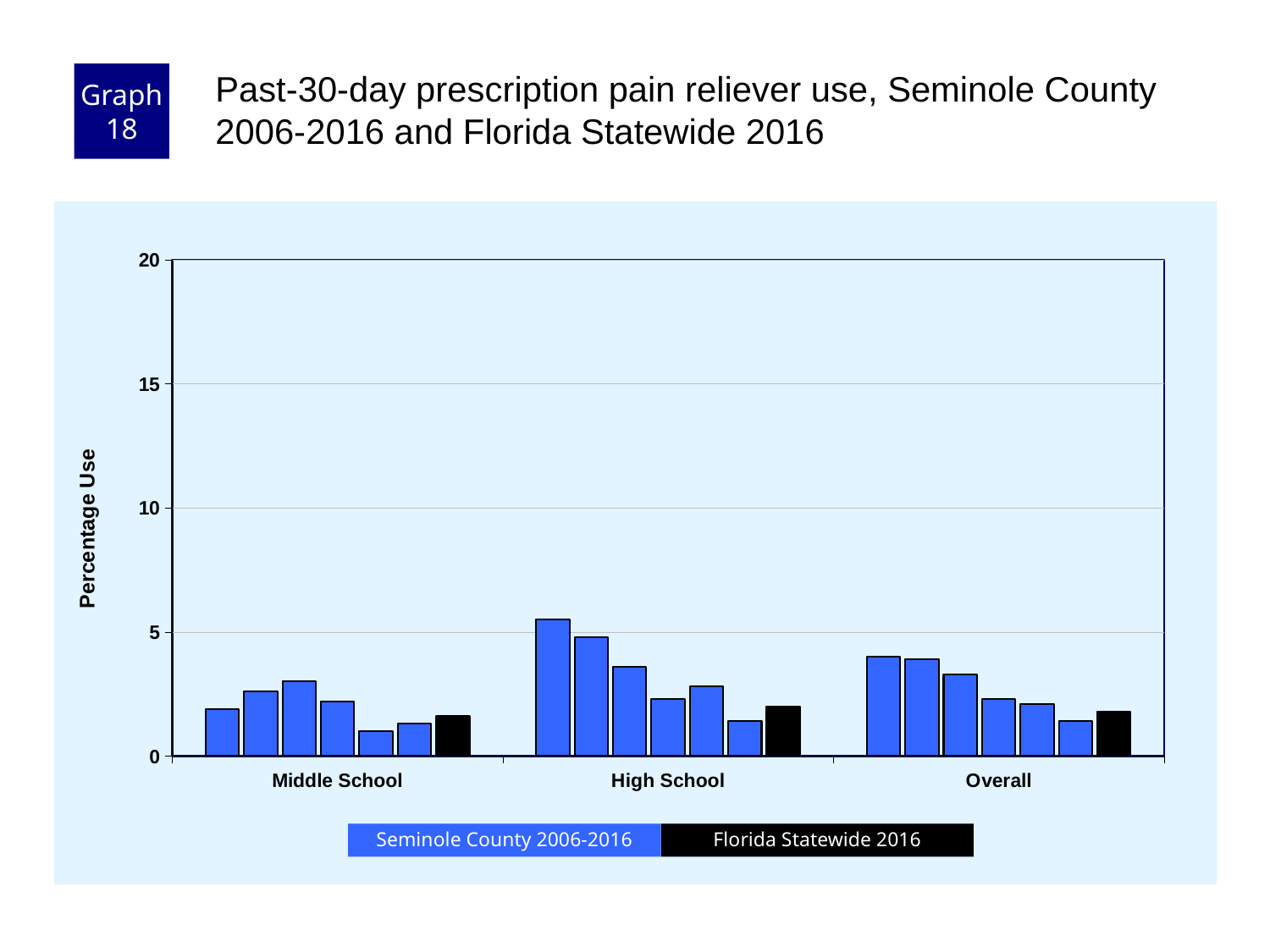
What kind of chart is shown on the slide? bar chart What is the label on the y axis? Percentage Use How many categories are shown on the x axis? 3 Is the value for the tallest Seminole County bar in the High School group greater or less than 5? greater Do the Seminole County 2006-2016 bars in the High School group generally rise or fall from left to right? fall Are any bars in the Overall group greater than 10? no What colour represents Florida Statewide 2016 in the legend? black Is the value for the Florida Statewide 2016 bar in the Middle School group greater or less than 5? less Which category group contains the tallest bar on the chart? High School How many series does the legend list? 2 Which category has the highest Florida Statewide 2016 value? High School